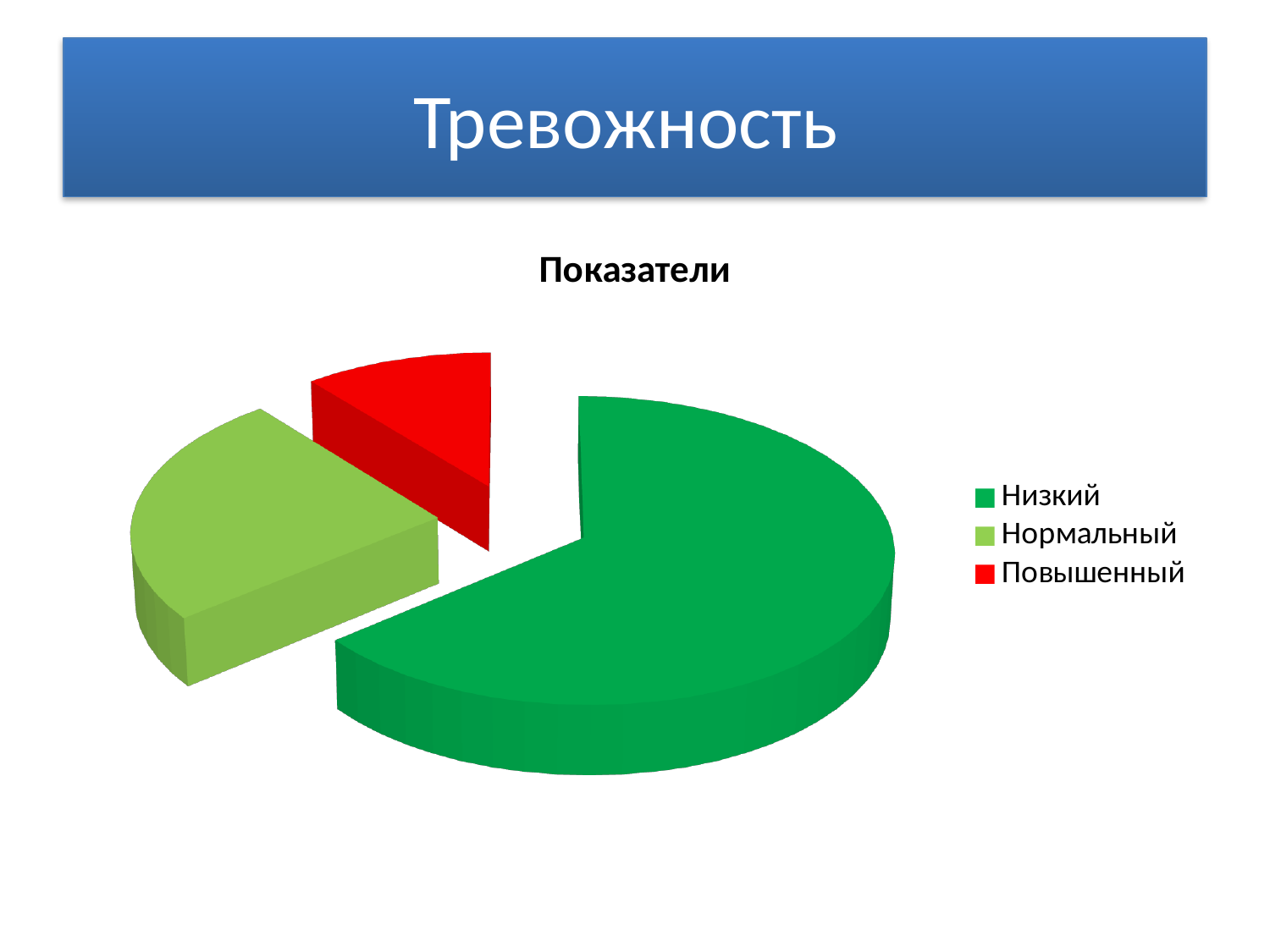
Does the Низкий slice take up more or less than half of the pie? more Which slice is larger, Низкий or Нормальный? Низкий Which category has the smallest slice of the pie? Повышенный Which slice is larger, Нормальный or Повышенный? Нормальный How many categories does the pie chart have? 3 What colour is the slice for Повышенный? red Which category has the largest slice of the pie? Низкий What kind of chart is shown on the slide? pie chart What is the title of the chart? Показатели